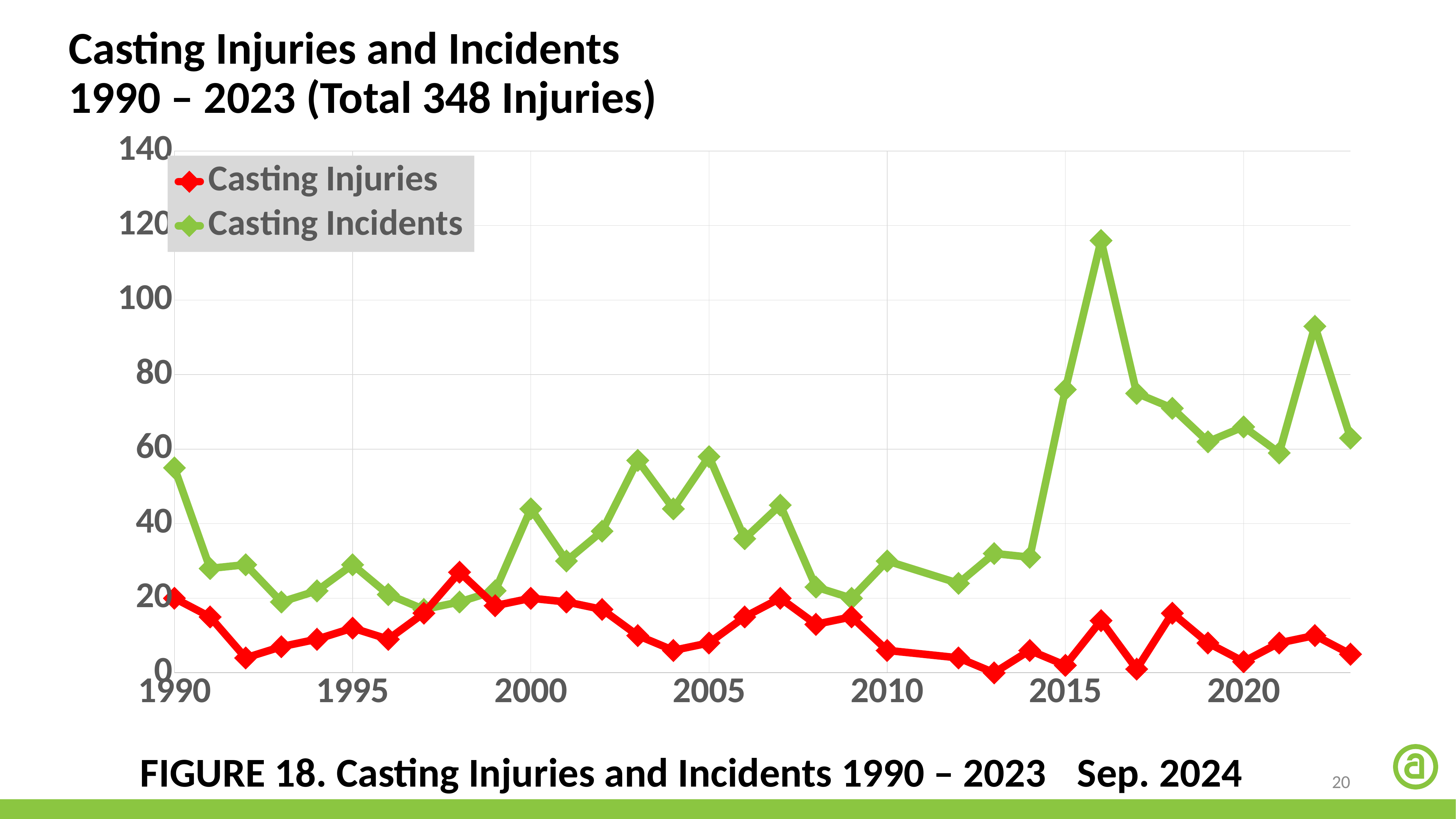
Which series is drawn in green? Casting Incidents In which year does the Casting Incidents series reach its highest value? 2016 Is the value for Casting Incidents in 2016 greater or less than 100? greater What kind of chart is shown on the slide? Line chart Which is larger, the Casting Incidents value in 2016 or in 2022? 2016 Is the value for Casting Injuries in 2016 greater or less than 20? less What is the title of the chart? Casting Injuries and Incidents 1990 – 2023 (Total 348 Injuries) Is the value for Casting Incidents in 2022 greater or less than 80? greater Does the Casting Incidents series rise or fall between 2014 and 2016? Rise In which year does the Casting Injuries series reach its lowest value? 2013 How many series does the legend list? 2